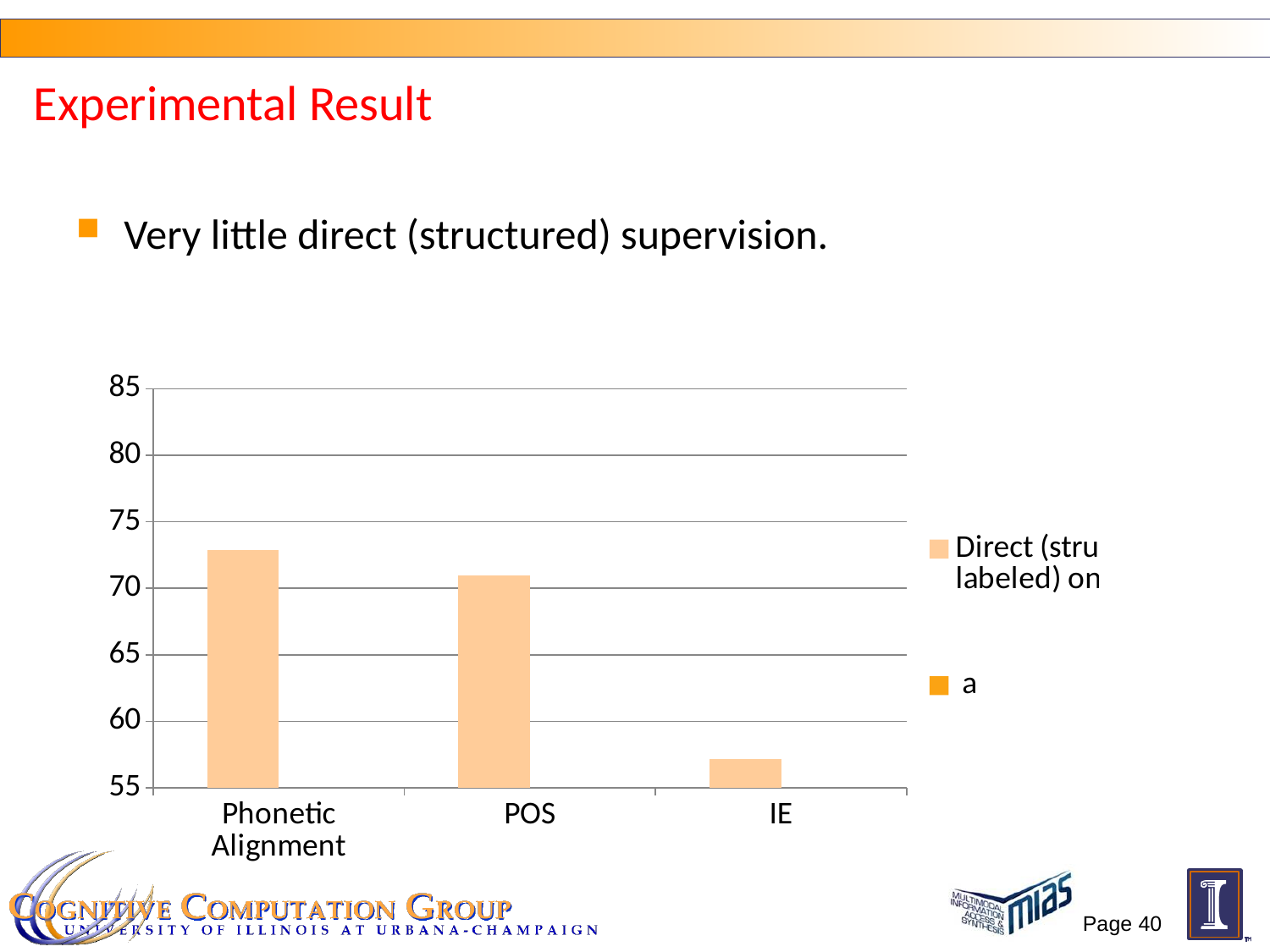
Is the value for POS greater or less than 75? less Which is larger, the value for POS or the value for IE? POS Is the value for Phonetic Alignment greater or less than 70? greater How many categories are shown on the x axis of the chart? 3 How many series does the chart's legend list? 2 Is the value for POS greater or less than 65? greater What kind of chart is shown on the slide? bar chart What is the label of the second entry in the chart's legend? a Which category has the lowest bar in the chart? IE Which category has the highest bar in the chart? Phonetic Alignment Do the bar values rise or fall from left to right across the x axis? fall